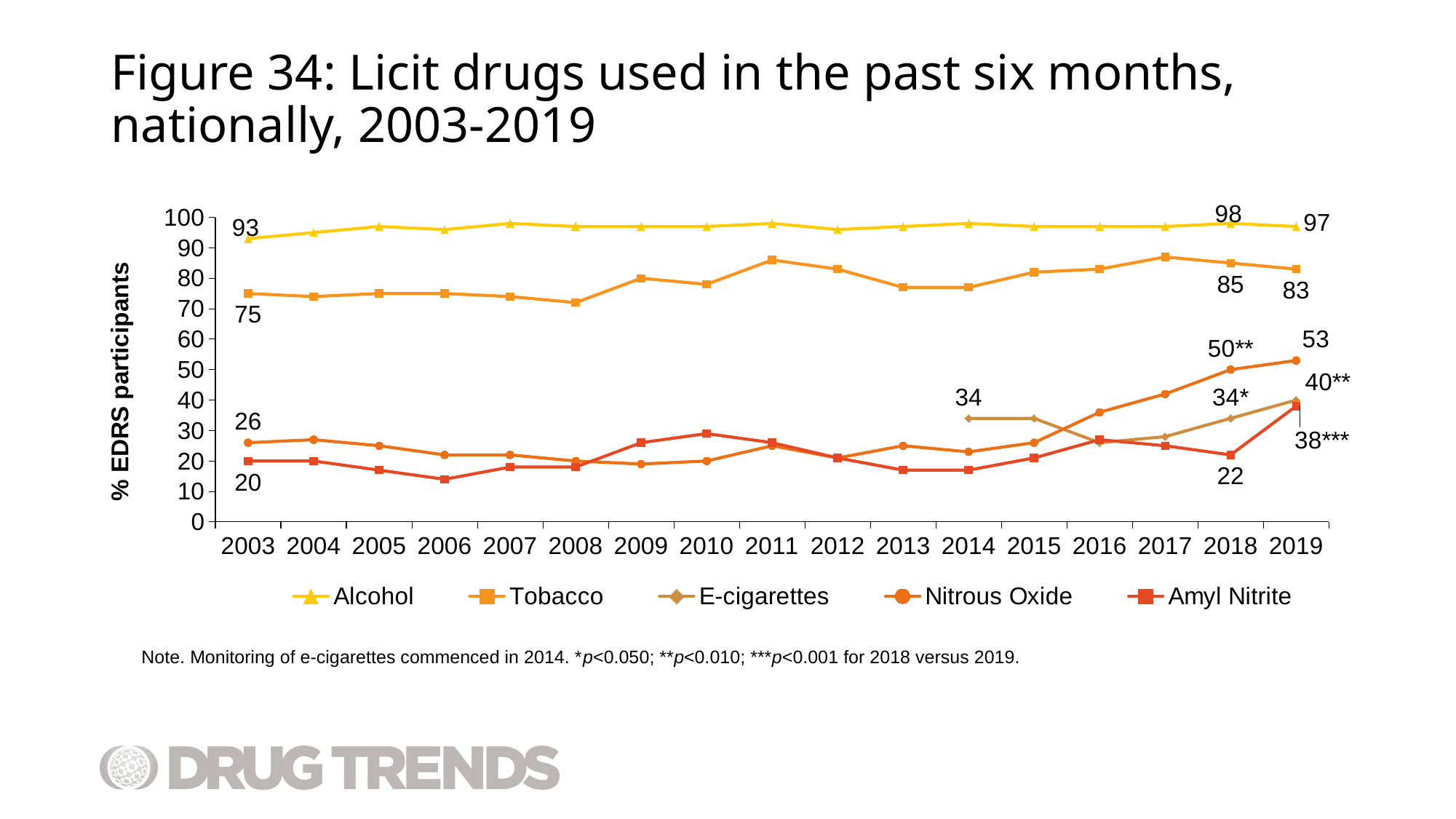
What is the value for Tobacco in 2003? 75 In 2019, which is larger: Tobacco or Nitrous Oxide? Tobacco Which series has the highest value in 2019? Alcohol What is the value for Alcohol in 2019? 97 How many series does the legend list? 5 What is the value for E-cigarettes in 2014? 34 What is the difference between the Alcohol values for 2018 and 2019? 1 What kind of chart is shown on the slide? line chart What is the value for Amyl Nitrite in 2018? 22 By how much did the Nitrous Oxide value increase from 2003 to 2019? 27 What is the value for Nitrous Oxide in 2019? 53 Is the value for Tobacco in 2011 greater or less than 80? greater